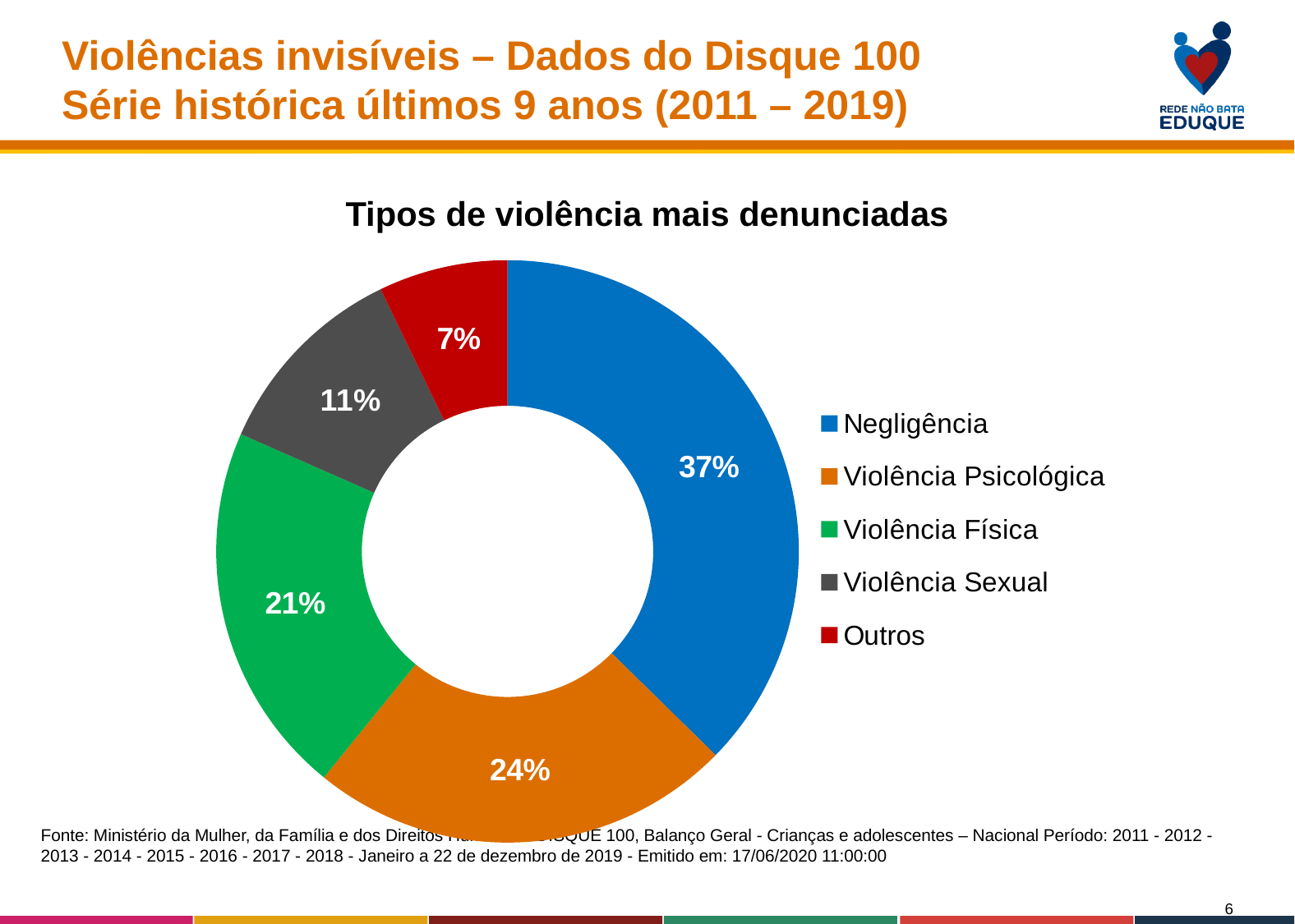
What is the value shown for Outros? 7% What is the value shown for Violência Psicológica? 24% What is the difference in percentage points between Negligência and Violência Psicológica? 13 How many categories are shown in the chart? 5 What kind of chart is shown on the slide? Doughnut (pie) chart What is the title of the chart? Tipos de violência mais denunciadas What share of the chart does Negligência represent? 37% Which category has the largest share in the chart? Negligência Which category has the smallest share in the chart? Outros What is the value shown for Violência Sexual? 11% What is the value shown for Violência Física? 21% Which is larger, the share for Violência Física or the share for Violência Sexual? Violência Física